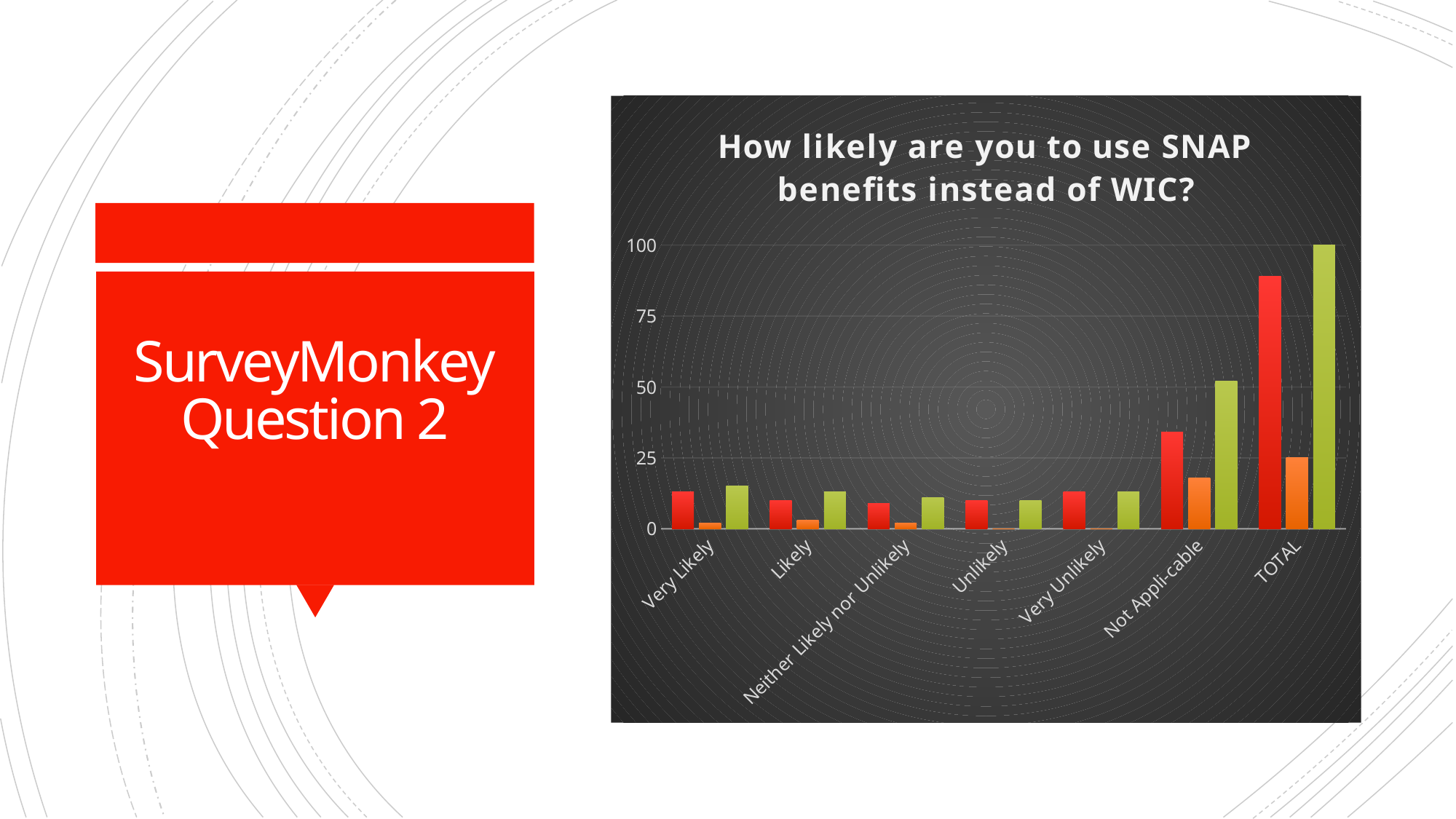
What is the title of the chart? How likely are you to use SNAP benefits instead of WIC? Is the red bar for TOTAL greater or less than 75? greater What kind of chart is shown on the slide? bar chart Is the green bar for Very Likely greater or less than 25? less For the TOTAL category, which is larger: the orange bar or the red bar? the red bar How many categories are shown along the x axis of the chart? 7 Is the orange bar for Not Appli-cable greater or less than 25? less Which category has the tallest red bar? TOTAL Which category has the tallest green bar? TOTAL For the Not Appli-cable category, which is larger: the red bar or the green bar? the green bar